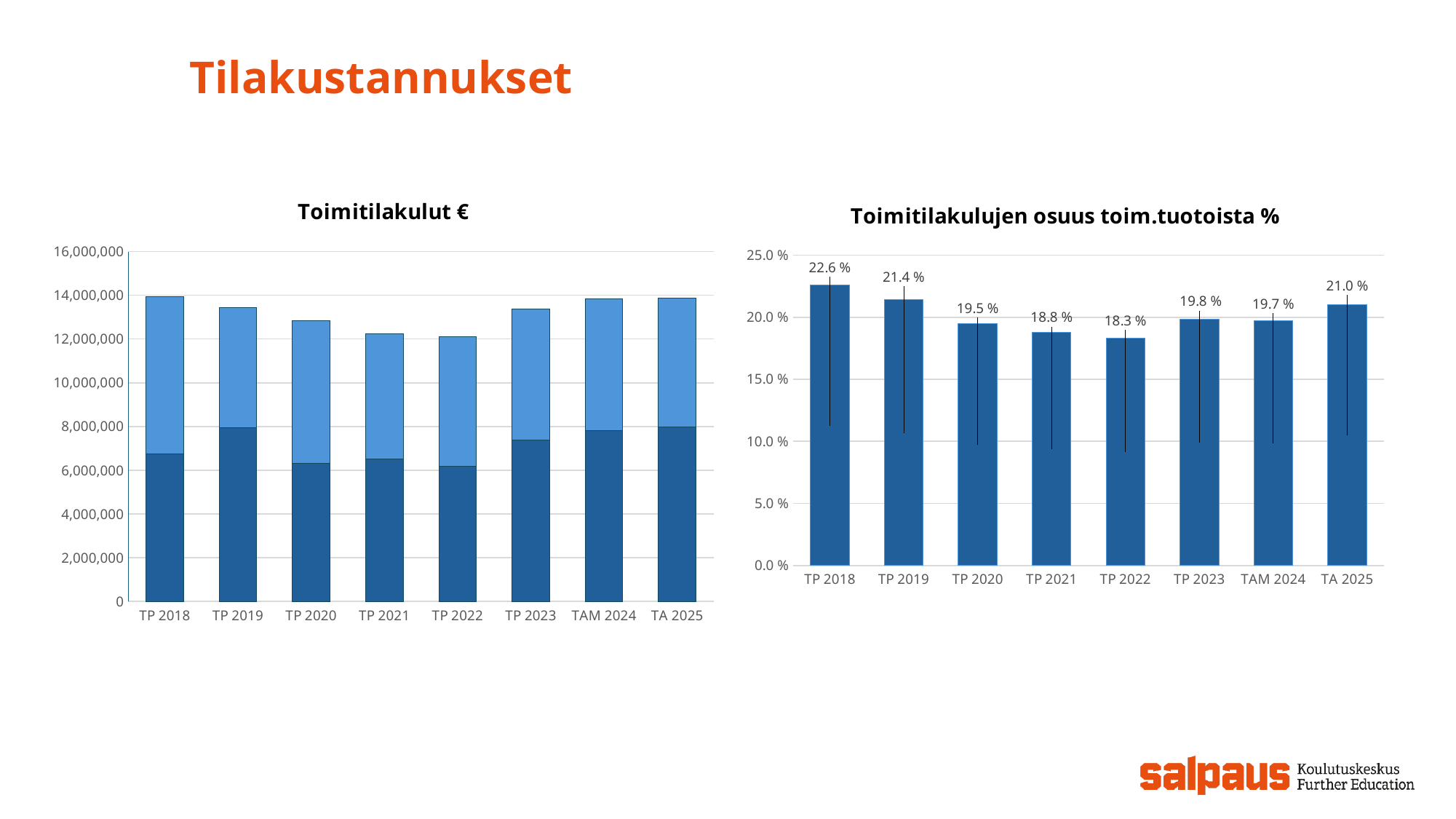
In the chart titled 'Toimitilakulujen osuus toim.tuotoista %', do the values rise or fall from TP 2018 to TP 2022? fall In the chart titled 'Toimitilakulut €', is the dark blue segment for TP 2022 greater or less than 8,000,000? less In the chart titled 'Toimitilakulut €', how many bars are shown? 8 In the chart titled 'Toimitilakulujen osuus toim.tuotoista %', how many categories are shown on the x axis? 8 In the chart titled 'Toimitilakulut €', is the total value of the TP 2018 bar greater or less than 12,000,000? greater In the chart titled 'Toimitilakulujen osuus toim.tuotoista %', which category has the highest value? TP 2018 In the chart titled 'Toimitilakulujen osuus toim.tuotoista %', what is the value for TAM 2024? 19.7 % In the chart titled 'Toimitilakulujen osuus toim.tuotoista %', which is larger, the value for TP 2019 or the value for TA 2025? TP 2019 In the chart titled 'Toimitilakulujen osuus toim.tuotoista %', what is the value for TP 2018? 22.6 % In the chart titled 'Toimitilakulujen osuus toim.tuotoista %', which category has the lowest value? TP 2022 In the chart titled 'Toimitilakulujen osuus toim.tuotoista %', what is the difference between the values for TP 2018 and TP 2022? 4.3 % What kind of chart is the chart titled 'Toimitilakulut €'? stacked bar chart